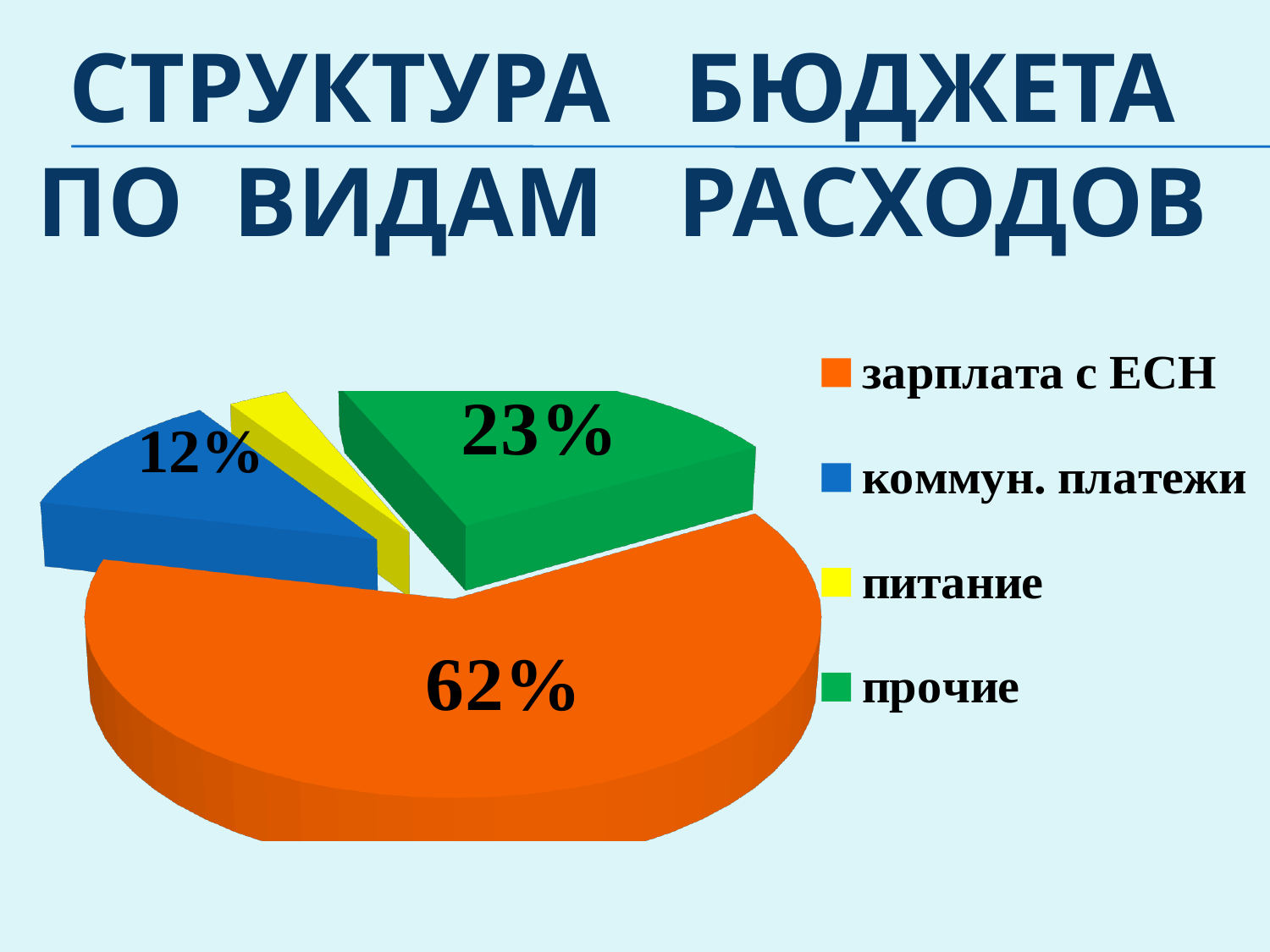
What share of the pie does зарплата с ЕСН take? 62% How many entries does the legend list? 4 Which is larger, the slice for прочие or the slice for коммун. платежи? прочие What colour is the slice for питание? Yellow What percentage is shown for коммун. платежи? 12% What type of chart is shown on the slide? Pie chart By how many percentage points does зарплата с ЕСН exceed прочие? 39 Which category has the smallest slice of the pie? питание What is the difference in percentage points between прочие and коммун. платежи? 11 How many slices does the pie chart have? 4 Which category has the largest slice of the pie? зарплата с ЕСН What percentage is shown for прочие? 23%